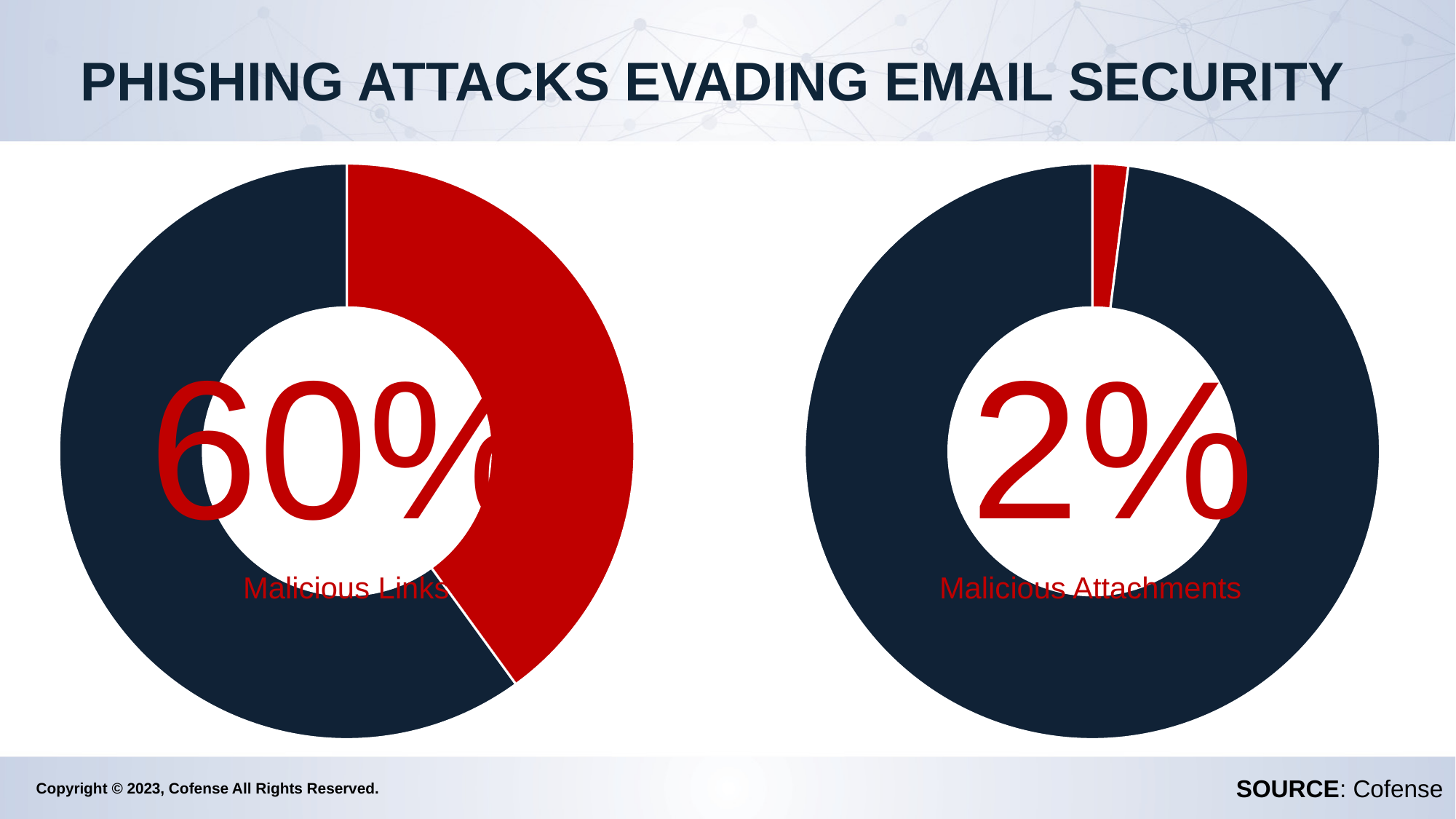
What percentage is shown in the Malicious Attachments chart? 2% How many charts are shown on the slide? 2 What is the title of the slide containing the two charts? PHISHING ATTACKS EVADING EMAIL SECURITY Which chart has the smaller highlighted slice, Malicious Links or Malicious Attachments? Malicious Attachments Which is larger, the Malicious Links percentage or the Malicious Attachments percentage? Malicious Links What colour is used for the highlighted slice in both charts? Red By how many percentage points does the Malicious Links value exceed the Malicious Attachments value? 58 percentage points What percentage is shown in the Malicious Links chart? 60% What kind of chart is used for Malicious Links on the left of the slide? Pie (donut) chart In the Malicious Attachments chart, what share of the pie is the red slice? 2%